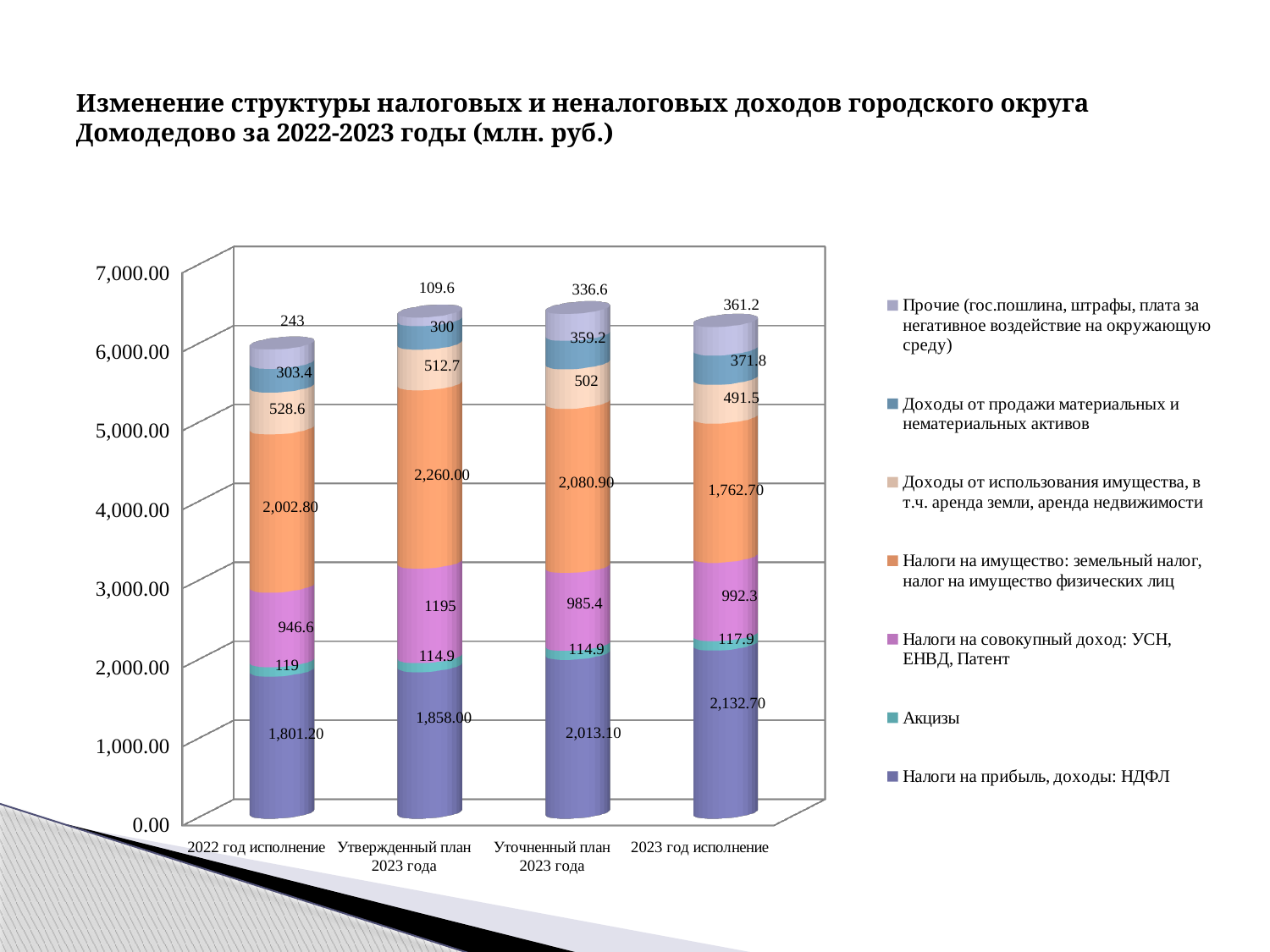
In which category is Прочие the lowest? Утвержденный план 2023 года Which is larger: Налоги на совокупный доход for Утвержденный план 2023 года or for Уточненный план 2023 года? Утвержденный план 2023 года How many series does the legend list? 7 Does the value of Налоги на прибыль, доходы: НДФЛ rise or fall from 2022 год исполнение to 2023 год исполнение? Rise How many categories are shown on the x axis? 4 What is the value of Акцизы for Уточненный план 2023 года? 114.9 What kind of chart is shown on the slide? Stacked bar chart In which category is Налоги на прибыль, доходы: НДФЛ the highest? 2023 год исполнение What is the difference between Налоги на имущество for Утвержденный план 2023 года and for 2023 год исполнение? 497.30 What is the value of Налоги на прибыль, доходы: НДФЛ for 2023 год исполнение? 2,132.70 What is the value of Налоги на имущество for Утвержденный план 2023 года? 2,260.00 What is the value of Прочие for 2022 год исполнение? 243